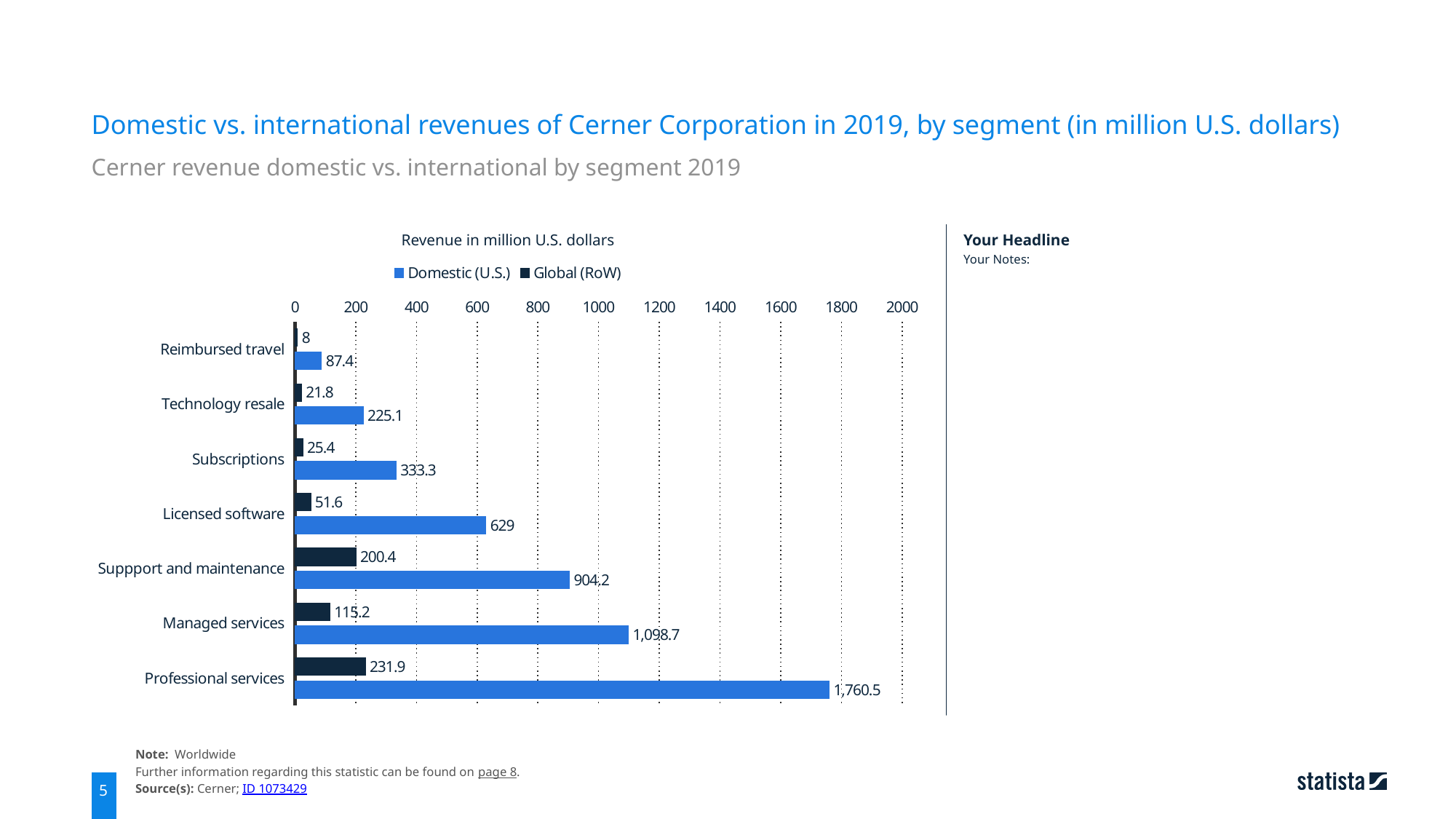
What is the Domestic (U.S.) revenue for Professional services? 1,760.5 What is the Domestic (U.S.) revenue for Licensed software? 629 Which segment has the lowest Global (RoW) revenue? Reimbursed travel What kind of chart is shown on the slide? Bar chart How many series does the legend list? 2 What is the difference between the Domestic (U.S.) and Global (RoW) revenues for Professional services? 1,528.6 Which is larger: the Global (RoW) revenue for Managed services or the Global (RoW) revenue for Support and maintenance? Support and maintenance What is the Global (RoW) revenue for Reimbursed travel? 8 How many segments are shown on the chart? 7 What is the Global (RoW) revenue for Support and maintenance? 200.4 Which segment has the highest Domestic (U.S.) revenue? Professional services Which colour represents the Domestic (U.S.) series? Blue